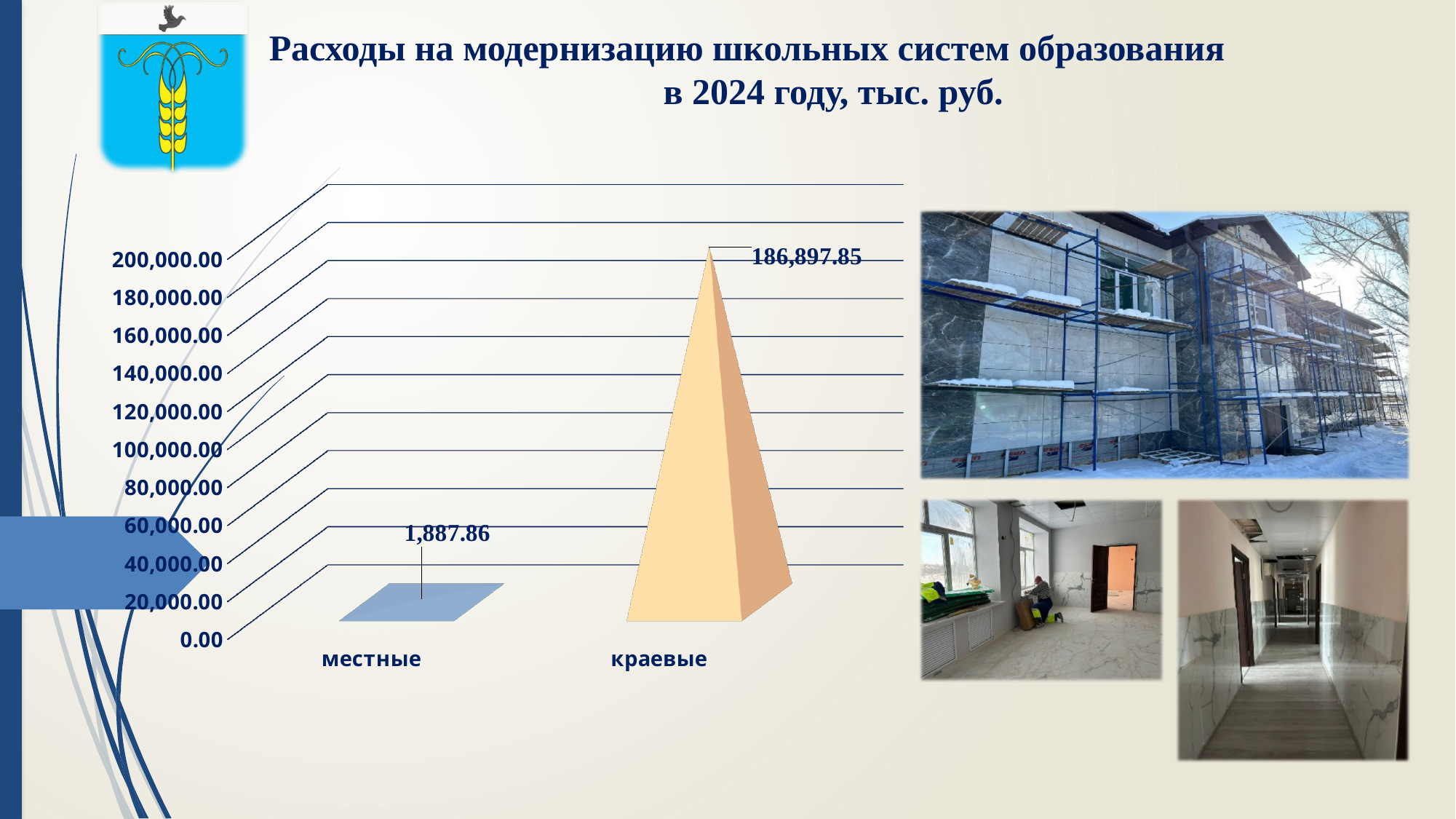
What is the difference between the values for краевые and местные? 185,009.99 Is the value for краевые greater or less than 180,000.00? greater Which is larger, the value for местные or the value for краевые? краевые How many categories are shown on the chart? 2 What is the value for местные? 1,887.86 What is the highest value shown on the vertical axis of the chart? 200,000.00 What kind of chart is shown on the slide? bar chart What is the value for краевые? 186,897.85 What is the title of the chart on the slide? Расходы на модернизацию школьных систем образования в 2024 году, тыс. руб. Which category has the highest value? краевые Is the value for местные greater or less than 20,000.00? less Which category has the lowest value? местные